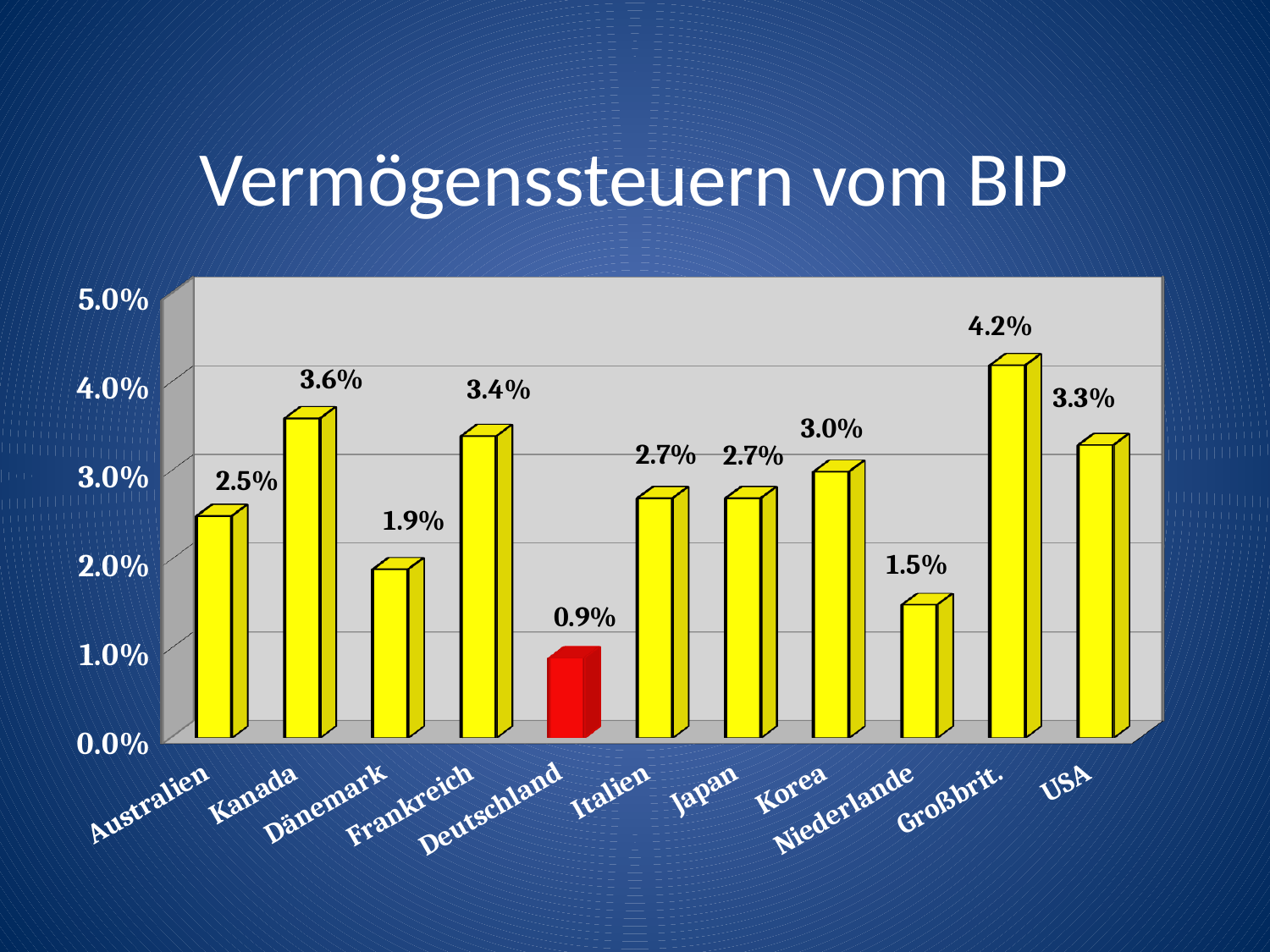
What kind of chart is shown? bar chart What is the value for Deutschland? 0.9% Which country has the lowest value? Deutschland Which is larger, the value for USA or the value for Korea? USA What is the value for Niederlande? 1.5% What is the value for Kanada? 3.6% Which country has the highest value? Großbrit. What is the title of the chart? Vermögenssteuern vom BIP How many countries are shown on the x axis? 11 What is the difference between the values for Großbrit. and Deutschland? 3.3% What is the difference between the values for Frankreich and Dänemark? 1.5% Which bar is coloured red instead of yellow? Deutschland